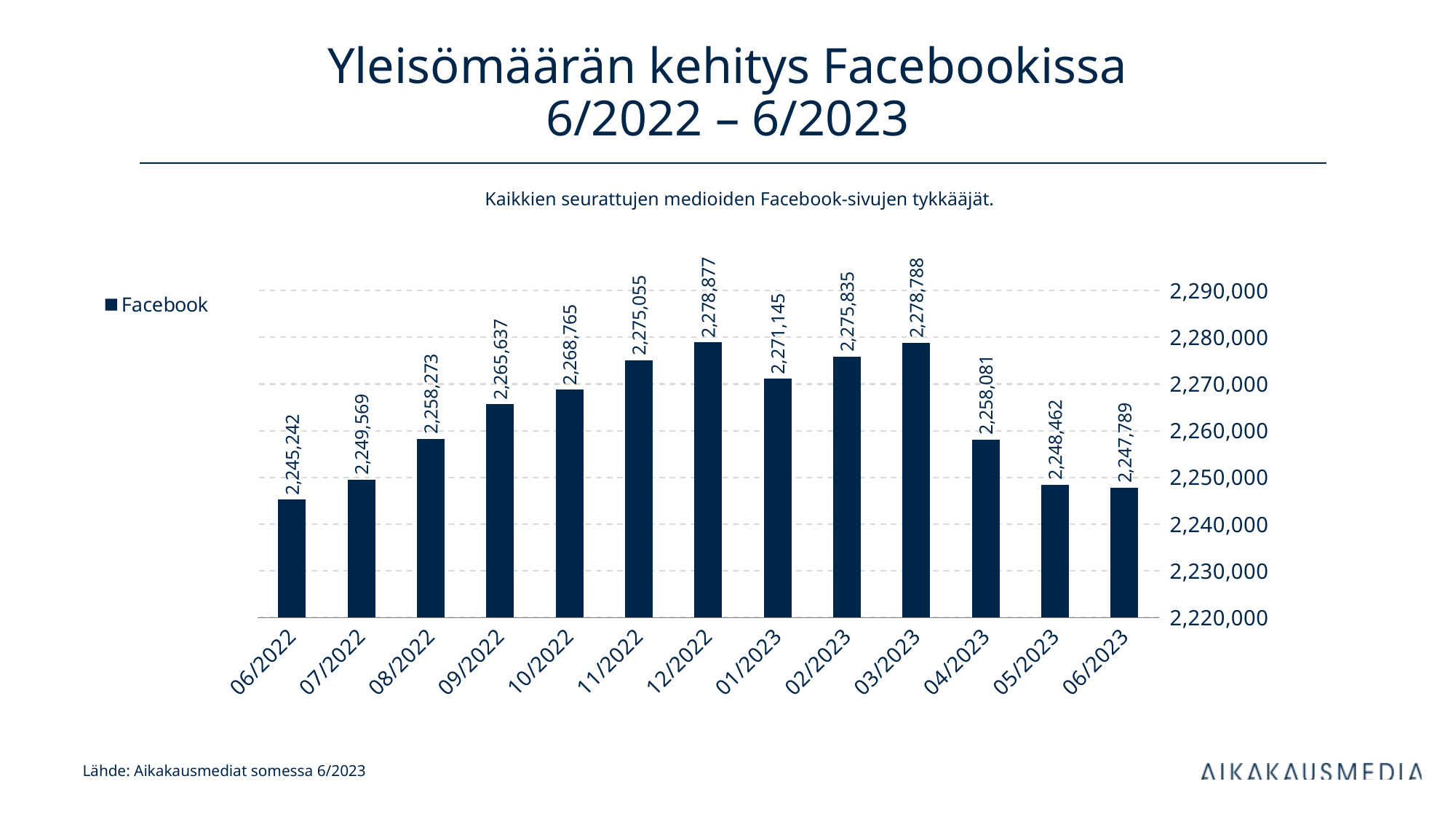
Which is larger, the value for 10/2022 or the value for 05/2023? 10/2022 What is the value for 04/2023? 2,258,081 What is the difference between the values for 03/2023 and 04/2023? 20,707 How many months are shown on the x axis? 13 Which month has the lowest value? 06/2022 How many series does the legend list? 1 Which month has the highest value? 12/2022 Is the value for 09/2022 greater or less than 2,260,000? greater What is the value for 12/2022? 2,278,877 Do the values rise or fall from 06/2022 to 12/2022? rise What is the difference between the values for 12/2022 and 06/2022? 33,635 What is the value for 06/2022? 2,245,242